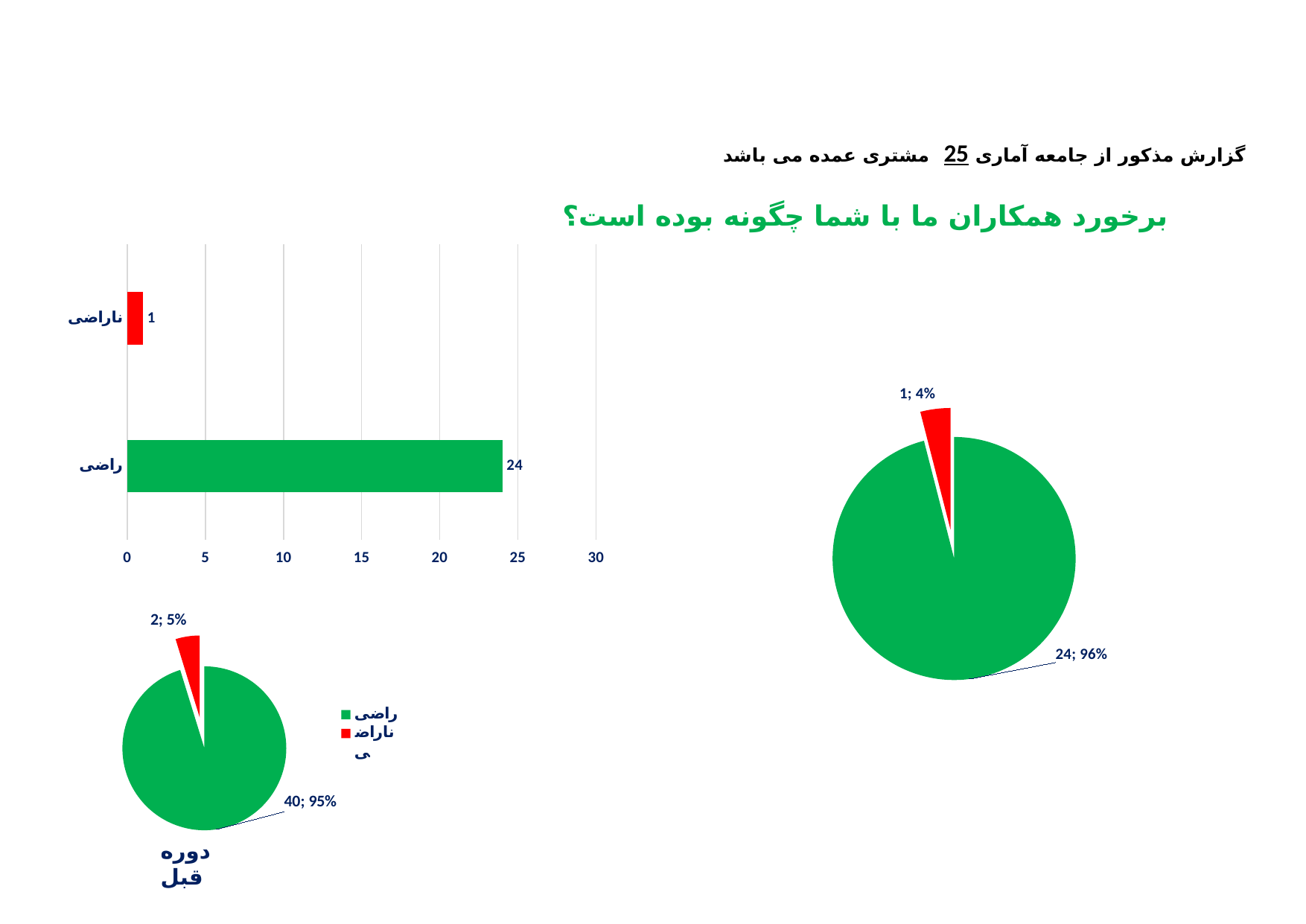
In the large pie chart on the right of the slide, what share does the red slice represent? 4% How many entries does the legend next to the small pie chart at the bottom left list? 2 In the bar chart on the left of the slide, how many categories are shown? 2 What kind of chart is the chart at the top left of the slide? bar chart In the bar chart on the left of the slide, what is the value for راضی? 24 In the large pie chart on the right of the slide, what share does the green slice represent? 96% In the bar chart on the left of the slide, which category has the highest value? راضی In the bar chart on the left of the slide, what is the difference between the values for راضی and ناراضی? 23 In the bar chart on the left of the slide, which category has the lowest value? ناراضی In the small pie chart labelled دوره قبل at the bottom left, what is the value and share of the green slice? 40; 95% In the bar chart on the left of the slide, what is the value for ناراضی? 1 In the small pie chart labelled دوره قبل at the bottom left, what share does the red slice represent? 5%